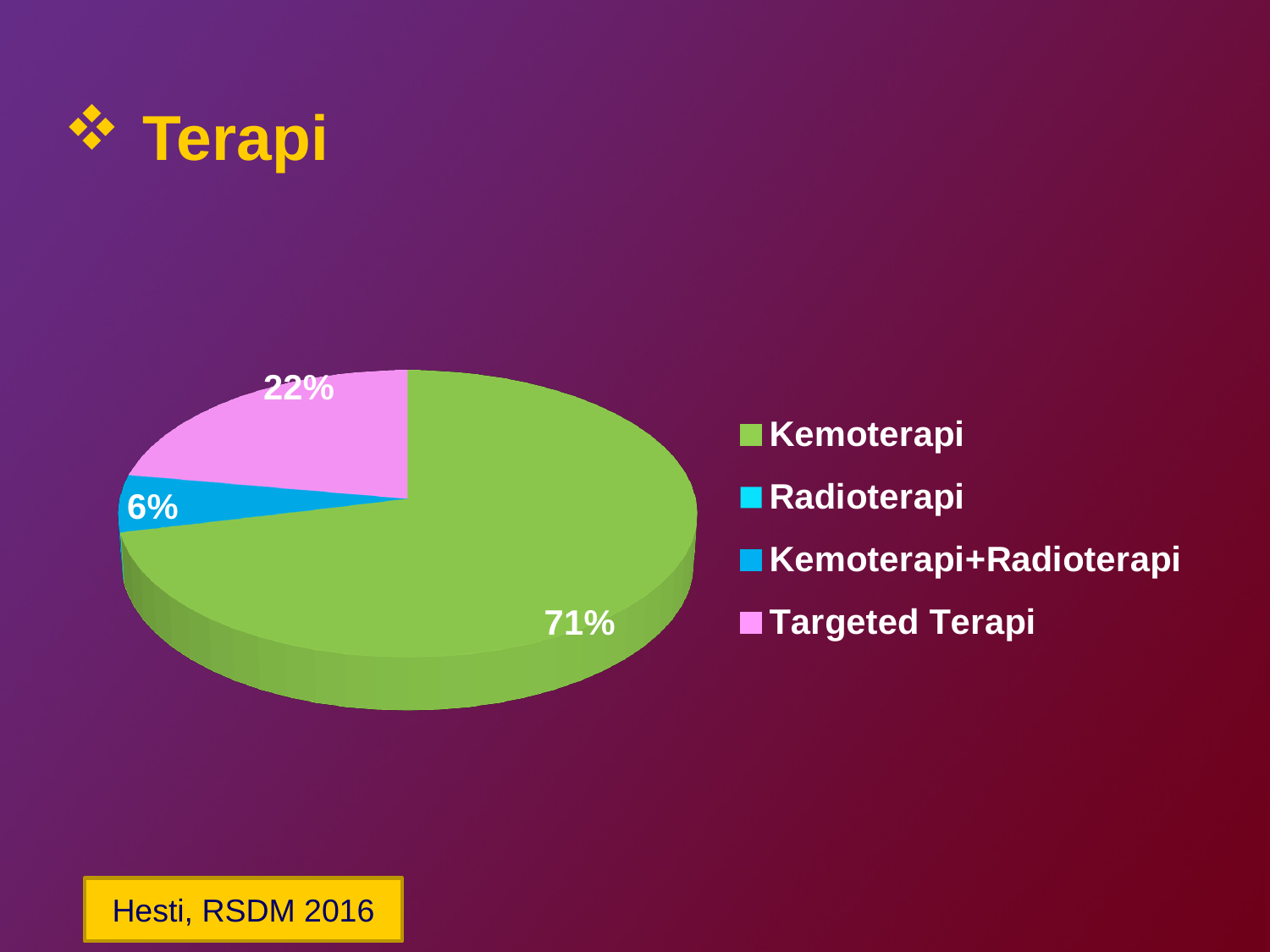
Which category has the largest slice of the pie? Kemoterapi How many categories does the legend list? 4 What is the title of the slide containing the pie chart? Terapi What type of chart is shown on the slide? pie chart What percentage of the pie is Kemoterapi+Radioterapi? 6% What percentage of the pie is Targeted Terapi? 22% What is the difference in percentage points between the Kemoterapi slice and the Targeted Terapi slice? 49 Which is larger, the slice for Kemoterapi or the slice for Targeted Terapi? Kemoterapi What colour is the Kemoterapi slice? green What percentage of the pie is Kemoterapi? 71% Which is larger, the slice for Targeted Terapi or the slice for Kemoterapi+Radioterapi? Targeted Terapi What is the difference in percentage points between the Targeted Terapi slice and the Kemoterapi+Radioterapi slice? 16